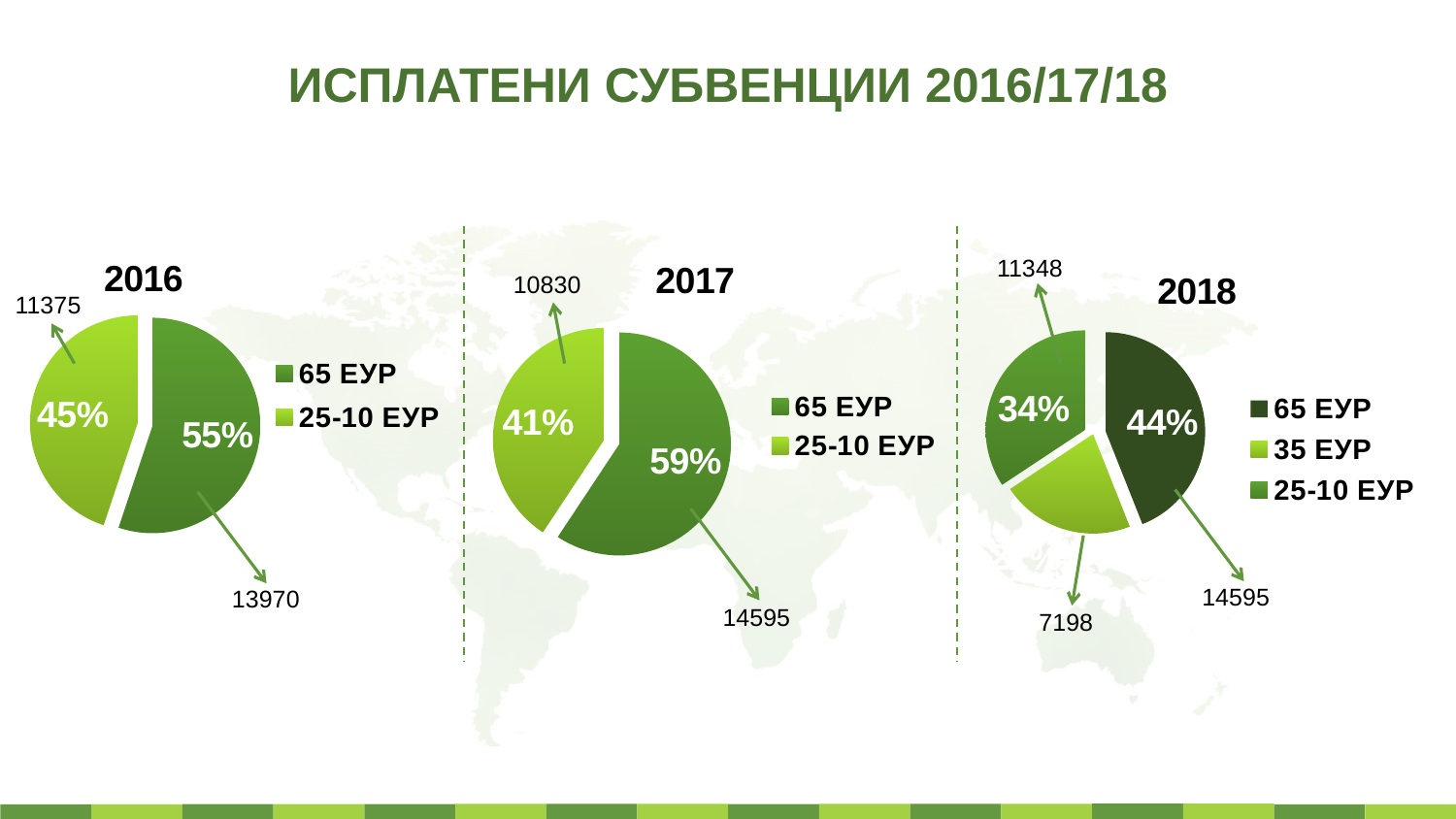
In the 2016 pie chart, what is the difference between the 65 ЕУР value and the 25-10 ЕУР value? 2595 What type of chart is used for the 2016 data? pie chart How many entries does the legend of the 2017 pie chart list? 2 In the 2016 pie chart, what value is shown for the 25-10 ЕУР slice? 11375 In the 2018 pie chart, what value is shown for the 35 ЕУР slice? 7198 In the 2017 pie chart, what share does the 25-10 ЕУР slice have? 41% In the 2018 pie chart, which category has the largest slice? 65 ЕУР In the 2017 pie chart, what value is shown for the 65 ЕУР slice? 14595 How many slices does the 2018 pie chart have? 3 In the 2018 pie chart, which category has the smallest slice? 35 ЕУР In the 2017 pie chart, which is larger, the 65 ЕУР slice or the 25-10 ЕУР slice? 65 ЕУР In the 2016 pie chart, what share does the 65 ЕУР slice have? 55%